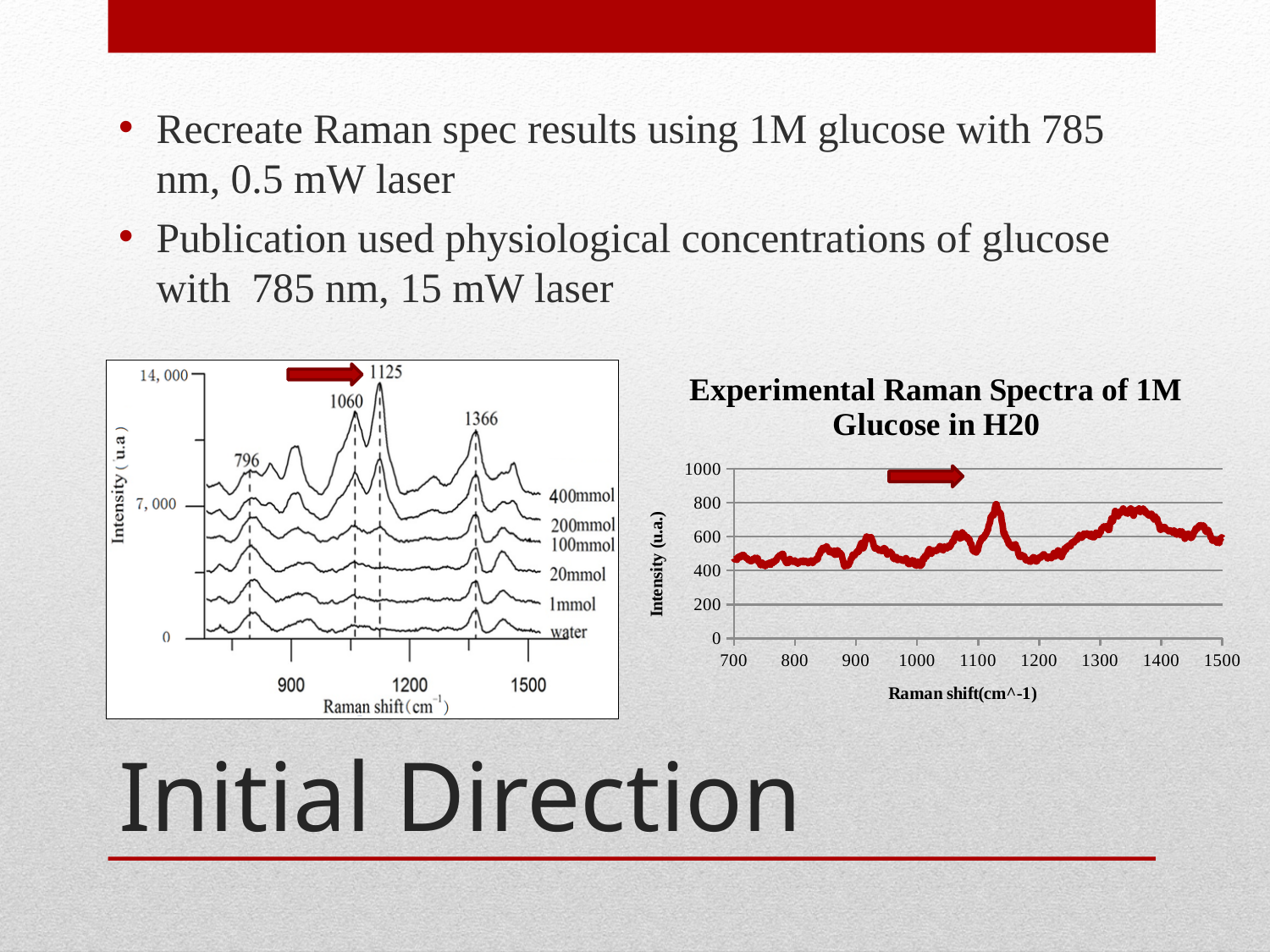
In the chart titled "Experimental Raman Spectra of 1M Glucose in H20", is the intensity at a Raman shift of 1200 greater or less than 600? less In the chart titled "Experimental Raman Spectra of 1M Glucose in H20", is the intensity at a Raman shift of 700 greater or less than 600? less What is the x-axis title of the chart titled "Experimental Raman Spectra of 1M Glucose in H20"? Raman shift(cm^-1) What kind of chart is the chart titled "Experimental Raman Spectra of 1M Glucose in H20"? line chart In the chart on the left of the slide, how many spectra (traces) are labelled? 6 In the chart titled "Experimental Raman Spectra of 1M Glucose in H20", is the intensity at any point greater or less than 1000? less In the chart on the left of the slide, which labelled peak has the lowest Raman shift? 796 In the chart titled "Experimental Raman Spectra of 1M Glucose in H20", which is larger: the intensity at a Raman shift of 1130 or at 1200? 1130 In the chart on the left of the slide, what is the highest intensity value shown on the y axis? 14, 000 In the chart on the left of the slide, what Raman shift is labelled at the tallest peak of the 400mmol trace? 1125